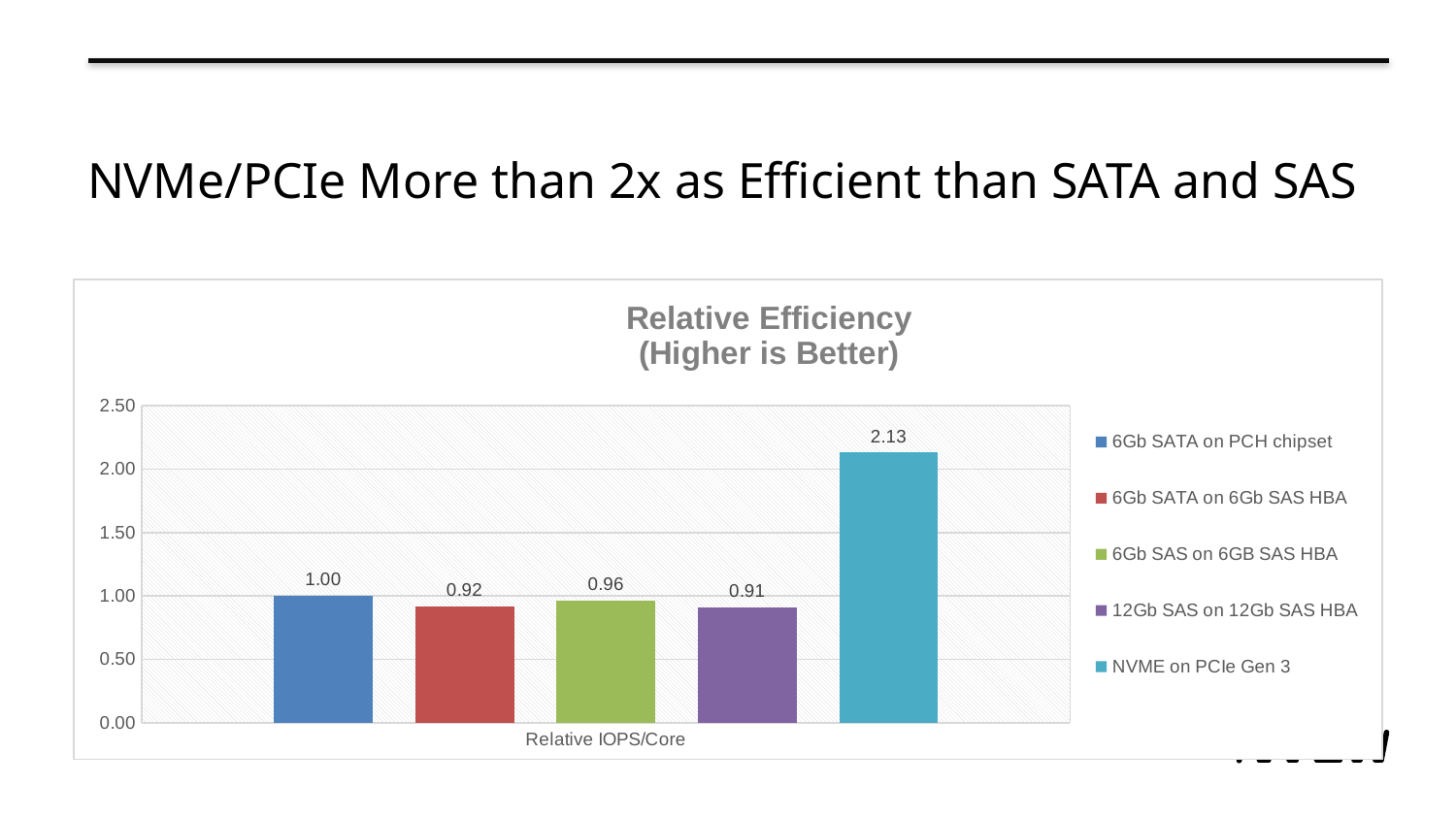
Which series has the highest value? NVME on PCIe Gen 3 How many series does the legend list? 5 What is the title of the chart? Relative Efficiency (Higher is Better) Is the value for NVME on PCIe Gen 3 greater or less than 2.00? greater Which series has the lowest value? 12Gb SAS on 12Gb SAS HBA What is the difference between the values for NVME on PCIe Gen 3 and 6Gb SATA on PCH chipset? 1.13 What is the value for 6Gb SATA on PCH chipset? 1.00 What is the value for 12Gb SAS on 12Gb SAS HBA? 0.91 Which is larger, the value for 6Gb SATA on 6Gb SAS HBA or the value for 6Gb SAS on 6GB SAS HBA? 6Gb SAS on 6GB SAS HBA What is the value for NVME on PCIe Gen 3? 2.13 What kind of chart is shown on the slide? bar chart What is the value for 6Gb SAS on 6GB SAS HBA? 0.96